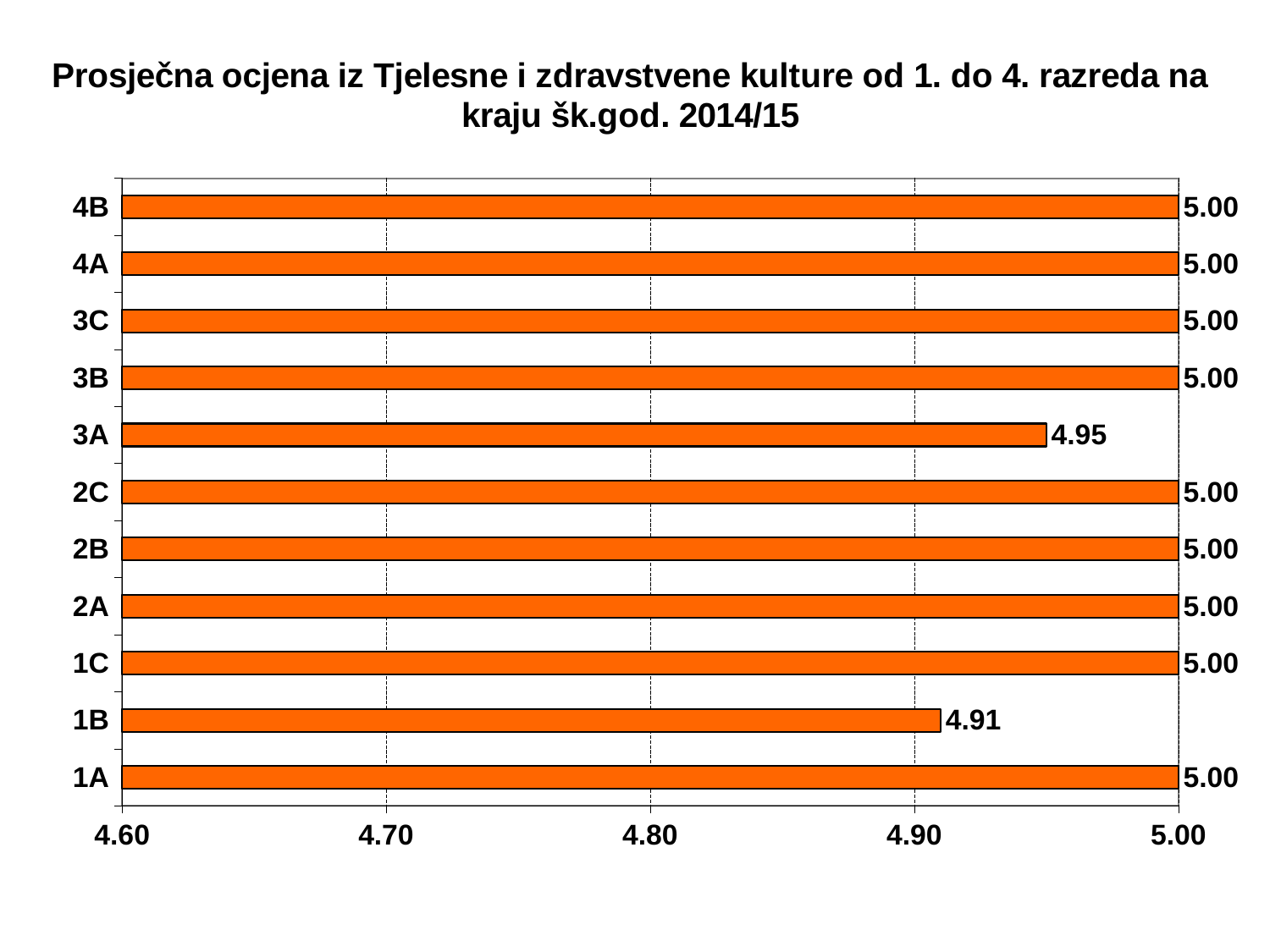
What is the average grade for class 3A? 4.95 How many classes have an average grade of 5.00? 9 What is the difference between the average grades of 4B and 1B? 0.09 What is the average grade for class 2C? 5.00 What colour are the bars in the chart? Orange How many classes are shown on the chart? 11 What kind of chart is shown on the slide? Bar chart Is the value for 1B greater or less than 4.90? greater Which class has the lowest average grade? 1B Which has a higher average grade, 3A or 1B? 3A What is the average grade for class 1B? 4.91 What is the difference between the average grades of 3A and 1B? 0.04